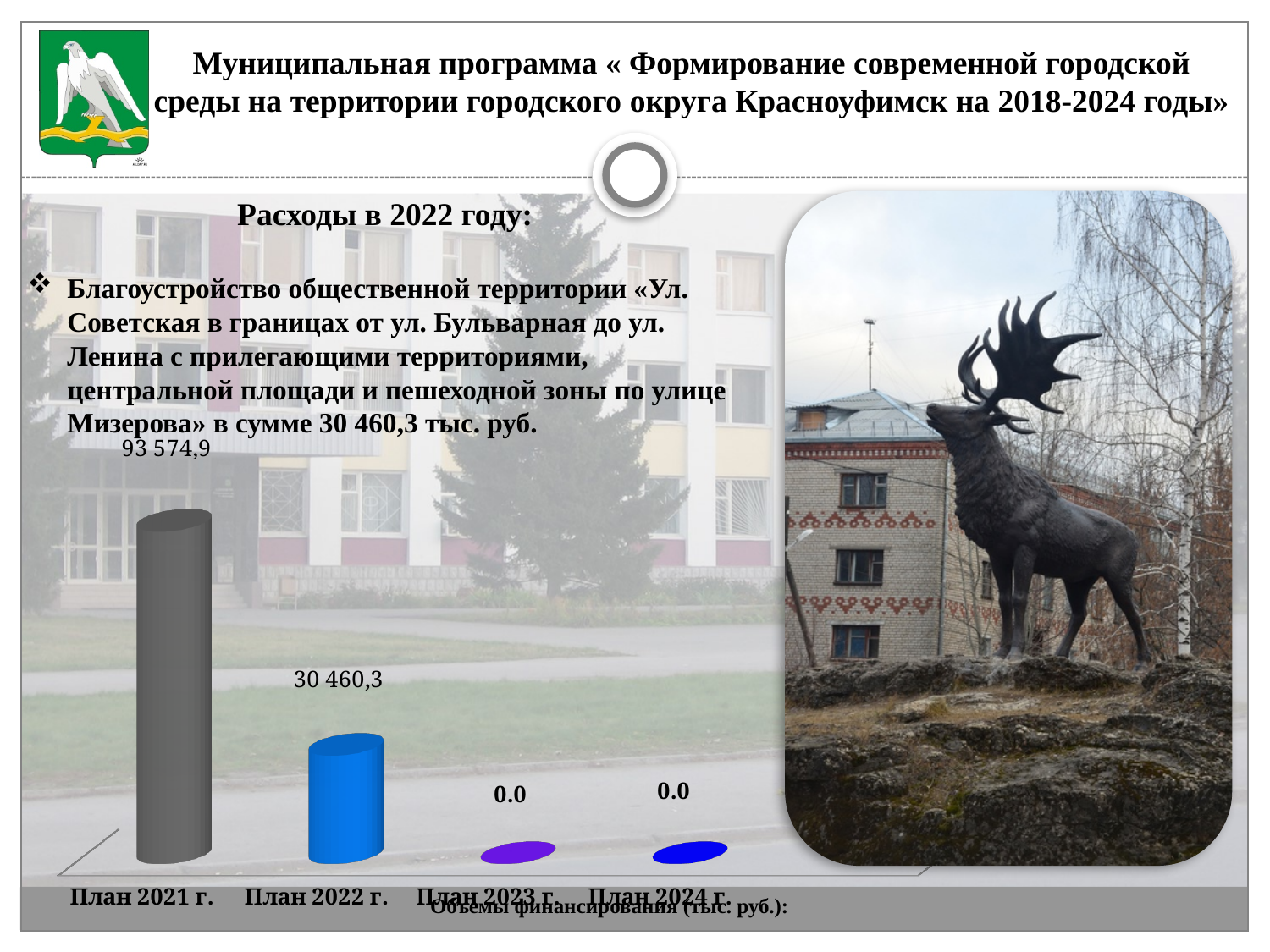
Which is larger, the value for План 2021 г. or the value for План 2022 г.? План 2021 г. What is the total of the values for План 2022 г., План 2023 г. and План 2024 г.? 30 460,3 What colour is the bar for План 2021 г.? Grey What kind of chart is shown on the slide? Bar chart What is the value for План 2023 г.? 0.0 How many categories are shown on the chart? 4 What is the difference between the values for План 2021 г. and План 2022 г.? 63 114,6 Which category has the highest value? План 2021 г. Do the values rise or fall from План 2021 г. to План 2024 г.? Fall What is the value for План 2024 г.? 0.0 What is the value for План 2022 г.? 30 460,3 What is the value for План 2021 г.? 93 574,9